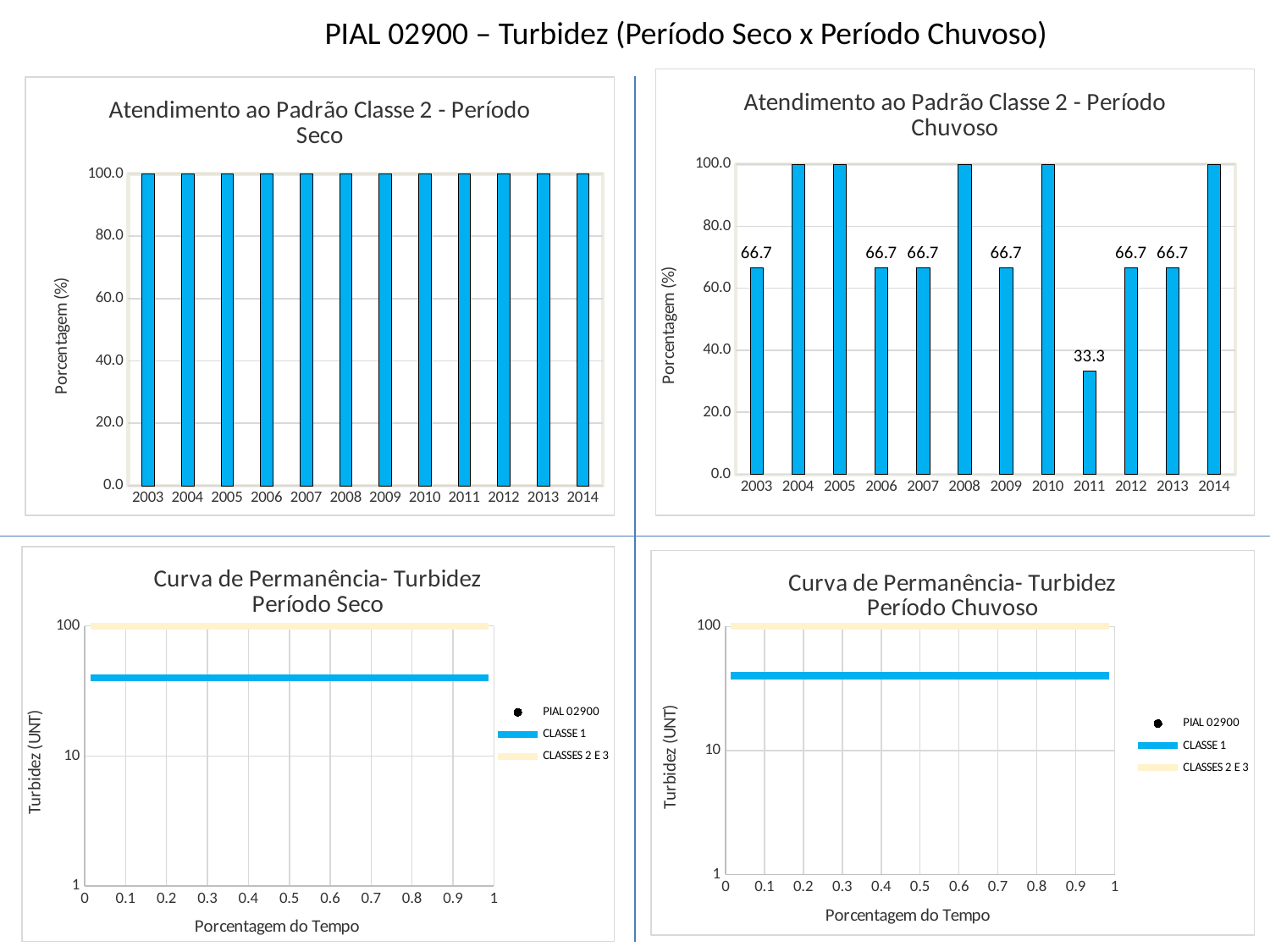
In the chart titled 'Atendimento ao Padrão Classe 2 - Período Chuvoso', which year has the lowest value? 2011 In the chart titled 'Atendimento ao Padrão Classe 2 - Período Seco', is the value for 2008 greater or less than 80.0? greater In the chart titled 'Atendimento ao Padrão Classe 2 - Período Chuvoso', what is the value for 2003? 66.7 What are the legend entries in the chart 'Curva de Permanência- Turbidez Período Chuvoso'? PIAL 02900, CLASSE 1, CLASSES 2 E 3 In the chart titled 'Atendimento ao Padrão Classe 2 - Período Chuvoso', is the value for 2011 greater or less than 40.0? less In the chart titled 'Atendimento ao Padrão Classe 2 - Período Chuvoso', how many years are shown on the x axis? 12 In the chart titled 'Atendimento ao Padrão Classe 2 - Período Chuvoso', how many years have a value of 66.7? 6 In the chart titled 'Atendimento ao Padrão Classe 2 - Período Chuvoso', which is larger, the value for 2004 or the value for 2006? 2004 In the chart titled 'Atendimento ao Padrão Classe 2 - Período Chuvoso', what is the value for 2011? 33.3 In the chart titled 'Atendimento ao Padrão Classe 2 - Período Chuvoso', what is the difference between the values for 2003 and 2011? 33.4 How many series does the legend of the chart 'Curva de Permanência- Turbidez Período Seco' list? 3 What kind of chart is 'Atendimento ao Padrão Classe 2 - Período Seco'? bar chart